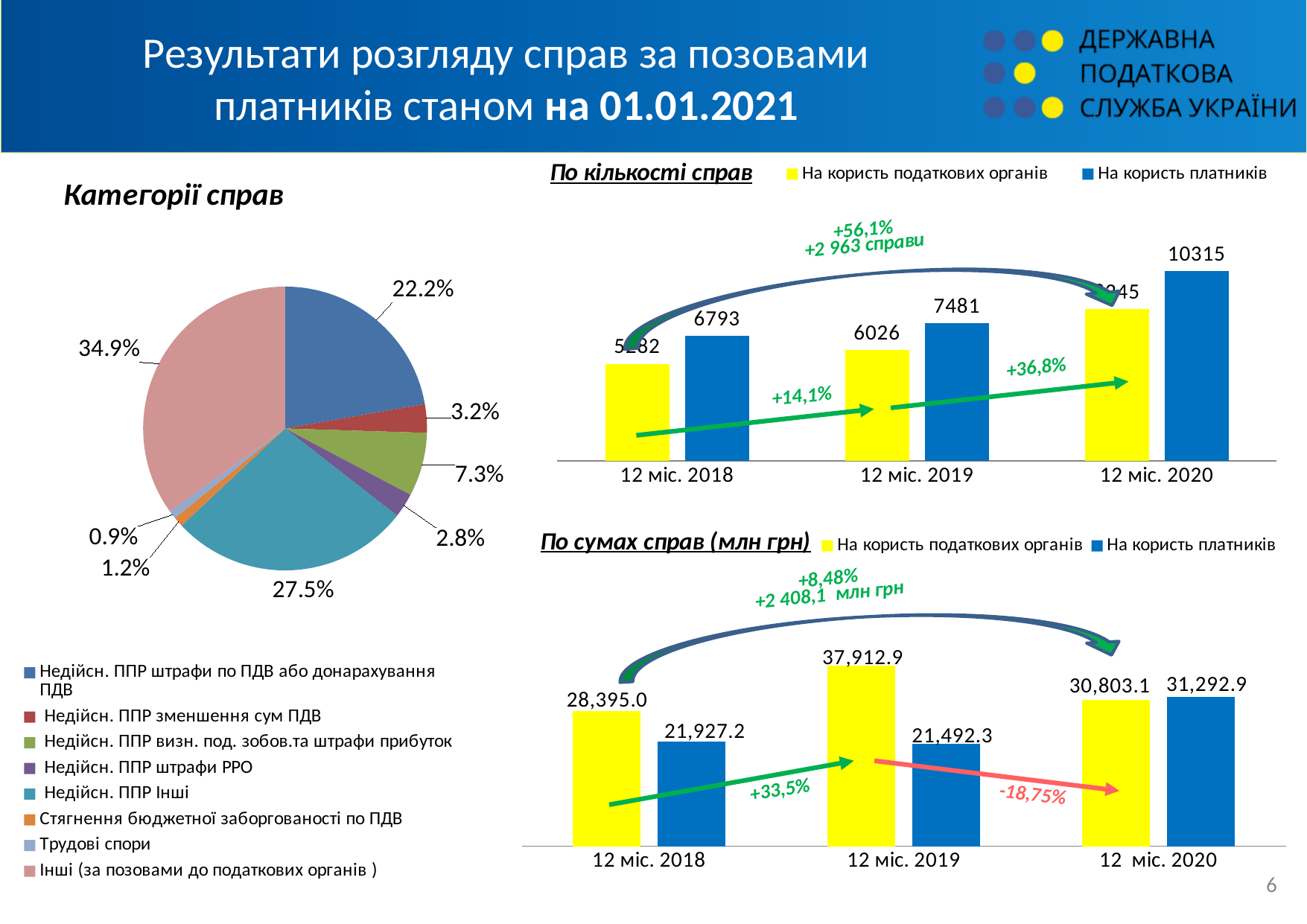
In the 'По кількості справ' chart, what is the value for 'На користь платників' in 12 міс. 2020? 10315 How many categories does the legend of the 'Категорії справ' pie chart list? 8 In the 'По кількості справ' chart, what is the value for 'На користь податкових органів' in 12 міс. 2019? 6026 In the 'По сумах справ (млн грн)' chart, does the value for 'На користь платників' rise or fall from 12 міс. 2018 to 12 міс. 2019? fall What kind of chart is the 'Категорії справ' chart? pie chart In the 'По сумах справ (млн грн)' chart, what is the difference between 'На користь податкових органів' in 12 міс. 2018 and 'На користь платників' in 12 міс. 2018? 6,467.8 How many series does the legend of the 'По кількості справ' chart list? 2 In the 'По сумах справ (млн грн)' chart, what is the value for 'На користь податкових органів' in 12 міс. 2019? 37,912.9 In the 'По сумах справ (млн грн)' chart, which is larger in 12 міс. 2020: 'На користь податкових органів' or 'На користь платників'? На користь платників In the 'Категорії справ' pie chart, what is the share of the smallest slice? 0.9% In the 'По кількості справ' chart, what is the difference between 'На користь платників' and 'На користь податкових органів' in 12 міс. 2019? 1455 In the 'Категорії справ' pie chart, what share does the largest slice have? 34.9%